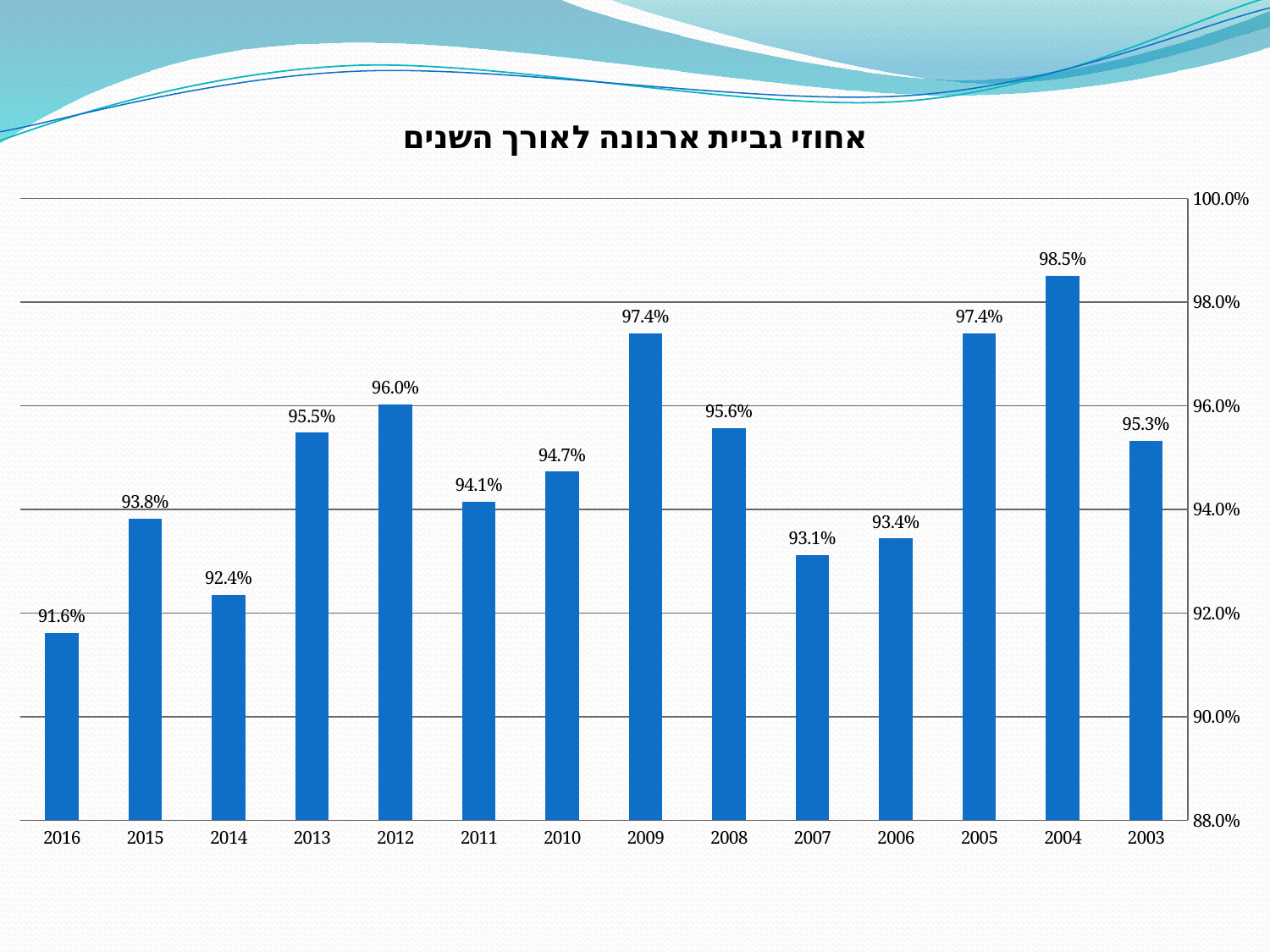
What kind of chart is shown on the slide? Bar chart Is the value for 2008 greater or less than 94.0%? greater What is the value shown for 2003? 95.3% Which year has the lowest collection percentage? 2016 What value is labelled on the bar for 2007? 93.1% Which year has a higher value, 2010 or 2011? 2010 What is the difference between the values for 2004 and 2016? 6.9% What is the difference between the values for 2013 and 2014? 3.1% Which year has the highest collection percentage? 2004 Which two years share the same value of 97.4%? 2009 and 2005 How many years are shown on the x axis? 14 What is the collection percentage shown for 2012? 96.0%